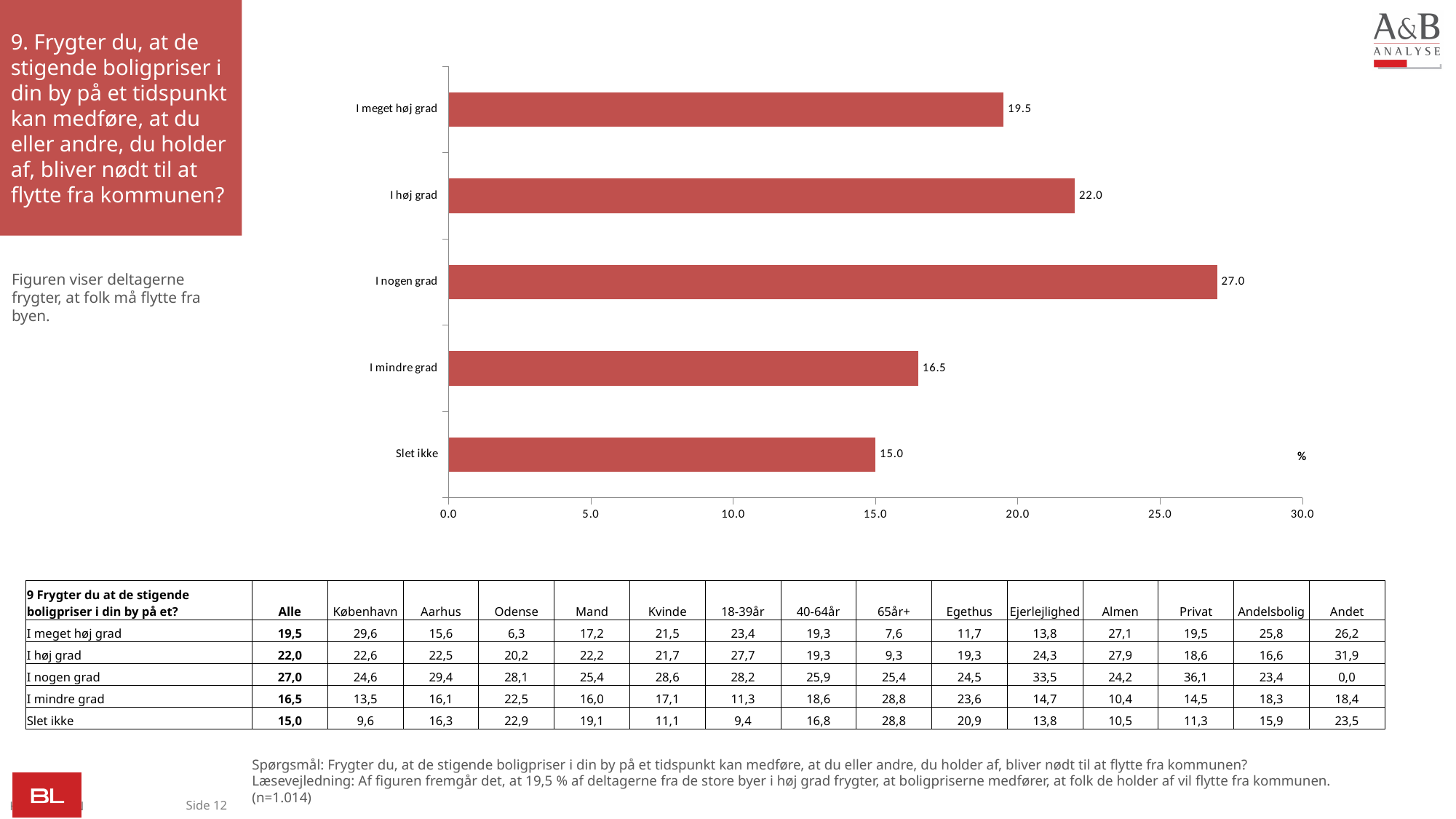
Which category has the lowest value? Slet ikke Is the value for "I høj grad" greater or less than 20.0? greater What is the value for "Slet ikke"? 15.0 Which is larger, the value for "I høj grad" or the value for "I meget høj grad"? I høj grad Which category has the highest value? I nogen grad What is the value for "I nogen grad"? 27.0 How many categories are shown in the chart? 5 What is the maximum value shown on the horizontal axis of the chart? 30.0 What is the value for "I meget høj grad"? 19.5 What kind of chart is shown on the slide? bar chart What is the difference between the values for "I nogen grad" and "I høj grad"? 5.0 What is the difference between the values for "I mindre grad" and "Slet ikke"? 1.5